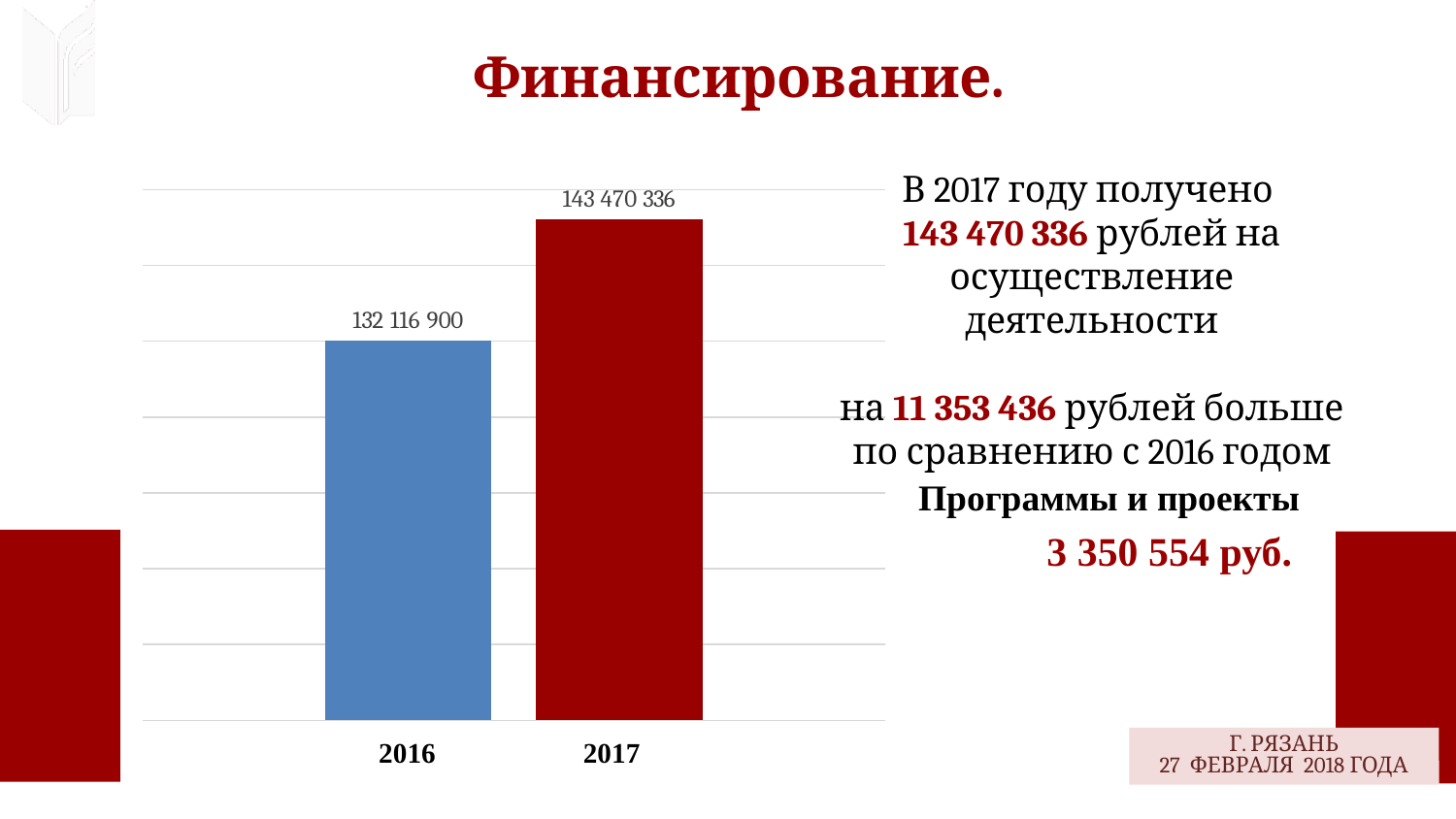
Do the values rise or fall from 2016 to 2017? rise How many bars are plotted in the chart? 2 Which year has the higher value? 2017 Is the value for 2017 larger or smaller than the value for 2016? larger By how much does the 2017 value exceed the 2016 value? 11 353 436 Which year has the lower value? 2016 What is the value shown for 2016? 132 116 900 What type of chart is shown on the slide? bar chart What colour is the bar for 2017? dark red What is the value shown for 2017? 143 470 336 What colour is the bar for 2016? blue